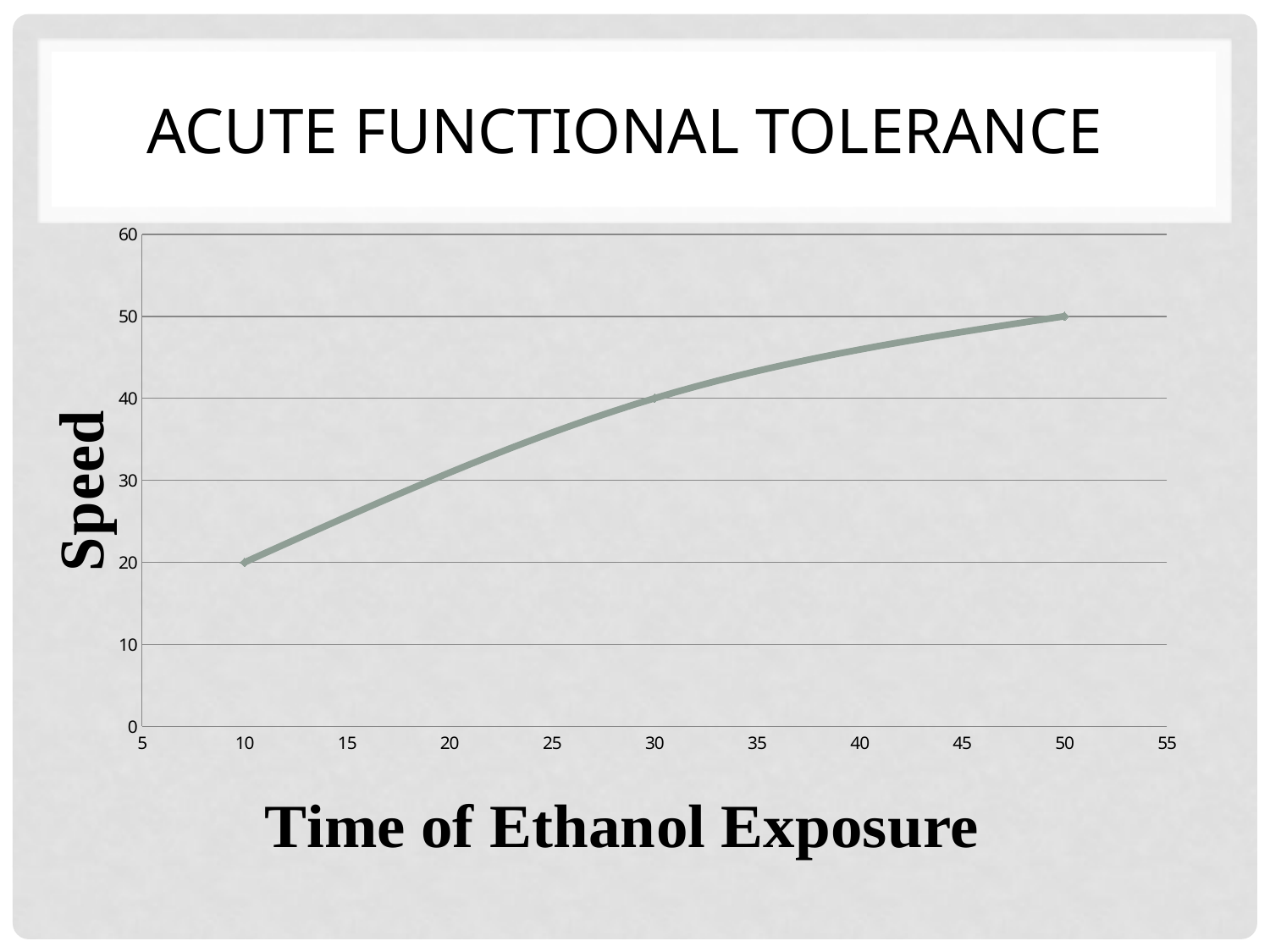
What is the Speed value at a Time of Ethanol Exposure of 30? 40 At which Time of Ethanol Exposure is Speed lowest? 10 What kind of chart is shown on the slide? line chart Which has the larger Speed: Time of Ethanol Exposure 30 or Time of Ethanol Exposure 10? 30 At which Time of Ethanol Exposure is Speed highest? 50 What is the difference in Speed between Time of Ethanol Exposure 50 and Time of Ethanol Exposure 10? 30 How many data points are marked on the line? 3 Does Speed rise or fall as Time of Ethanol Exposure increases? rise What is the label of the x axis? Time of Ethanol Exposure What is the title of the slide containing the chart? Acute Functional Tolerance What is the Speed value at a Time of Ethanol Exposure of 50? 50 What is the Speed value at a Time of Ethanol Exposure of 10? 20